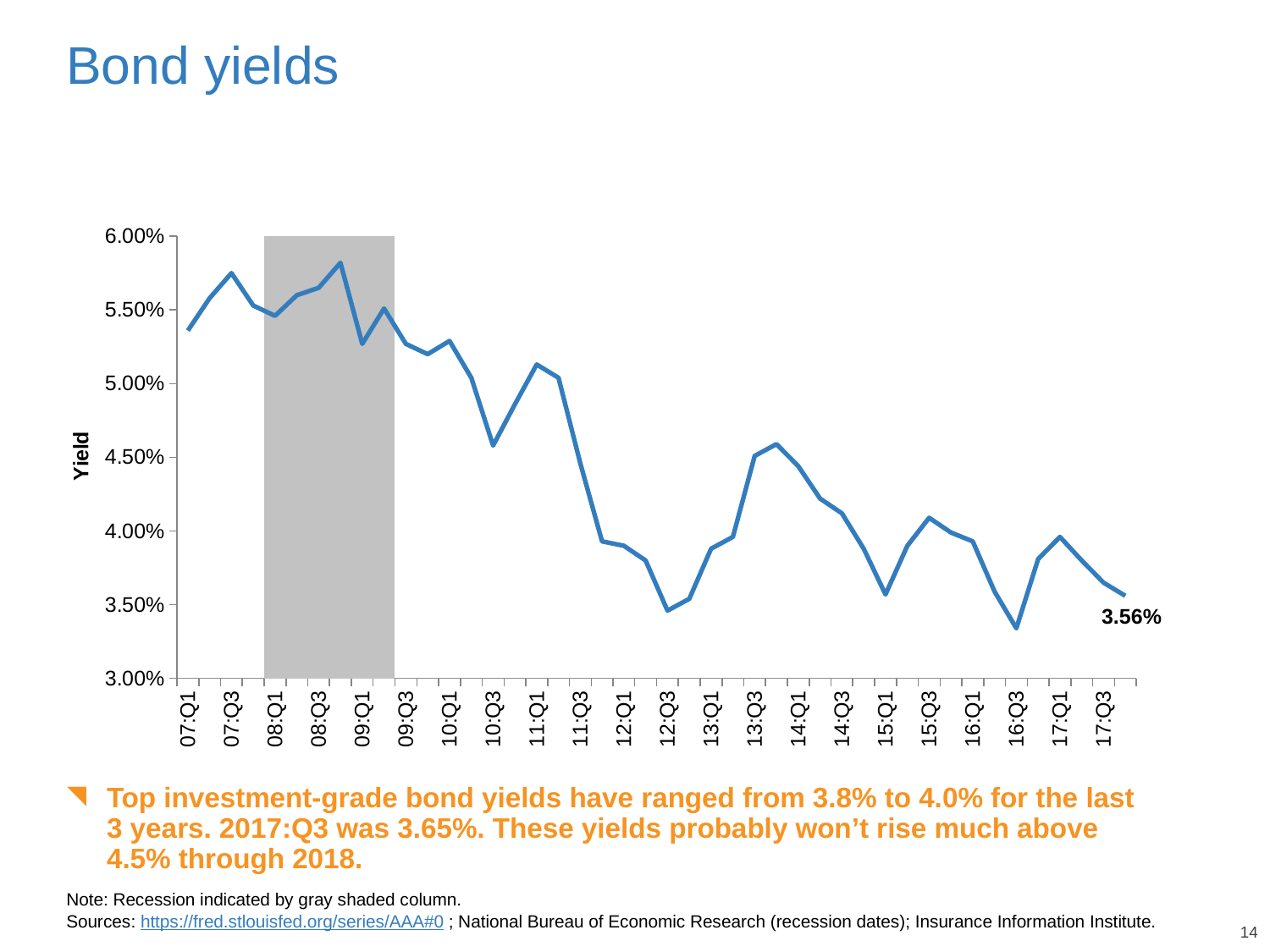
Is the yield at 15:Q1 greater or less than 4.00%? less Which is larger, the yield at 07:Q1 or the yield at 17:Q3? 07:Q1 Is the yield at 10:Q1 greater or less than 5.00%? greater What does the gray shaded column on the chart indicate? Recession Is the highest yield on the chart greater or less than 5.50%? greater What is the title of the vertical axis? Yield What kind of chart is shown on the slide? line chart Overall, do bond yields rise or fall from 07:Q1 to 17:Q3? fall